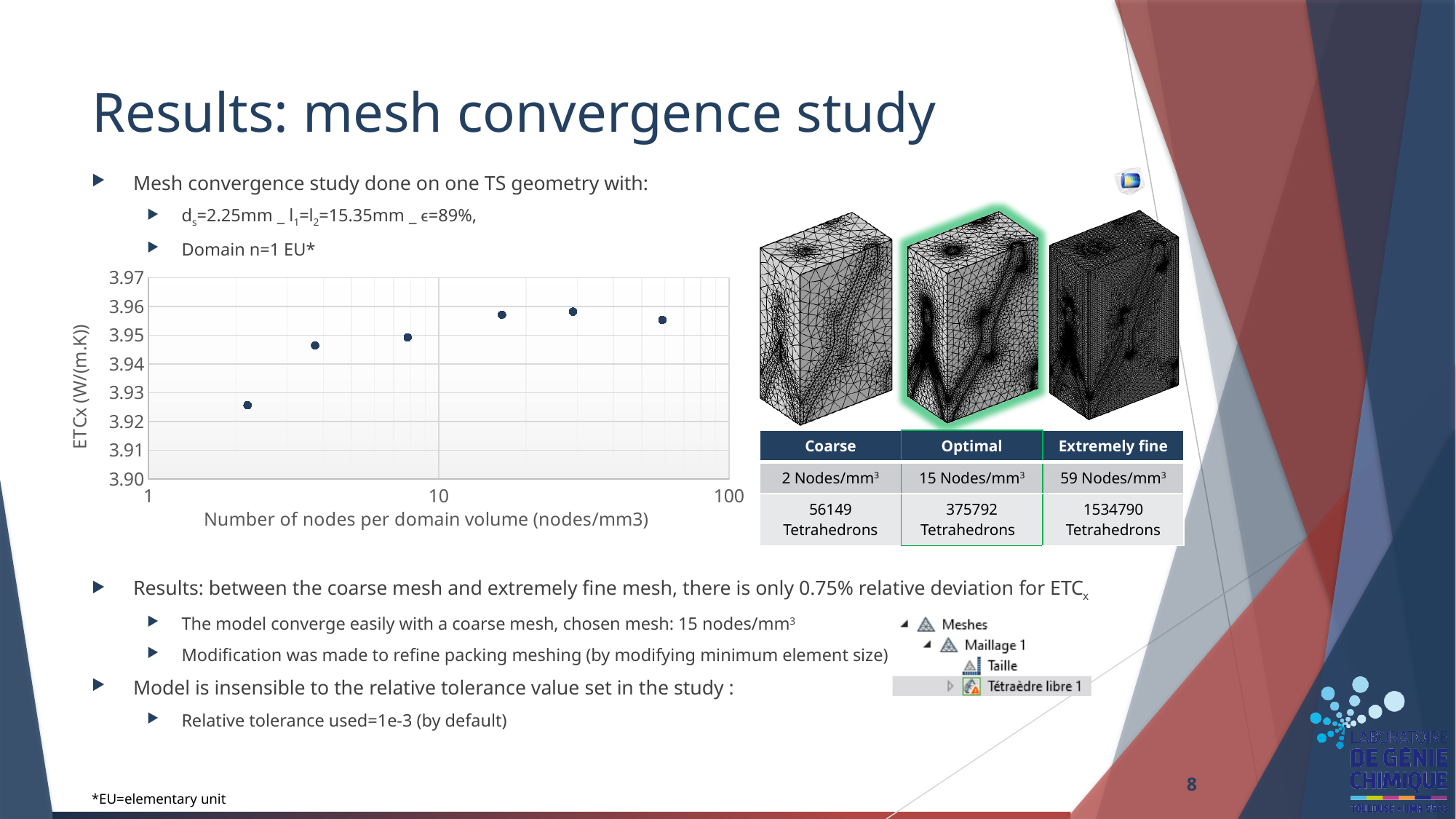
Is the ETCx value of the rightmost point (around 60 nodes/mm3) greater or less than 3.94? greater What is the label of the x axis of the chart? Number of nodes per domain volume (nodes/mm3) What is the highest value shown on the y axis of the chart? 3.97 Is the ETCx value of the point at about 4 nodes/mm3 greater or less than 3.95? less What is the label of the y axis of the chart? ETCx (W/(m.K)) Are all plotted ETCx values greater or less than 3.90? greater Do the ETCx values generally rise or fall as the number of nodes per domain volume increases? rise Which has a larger ETCx value: the point at about 2 nodes/mm3 or the point at about 16 nodes/mm3? the point at about 16 nodes/mm3 What kind of chart is shown on the slide? scatter chart How many data points are plotted in the chart? 6 Which point has the lowest ETCx value: the leftmost point or the rightmost point? the leftmost point